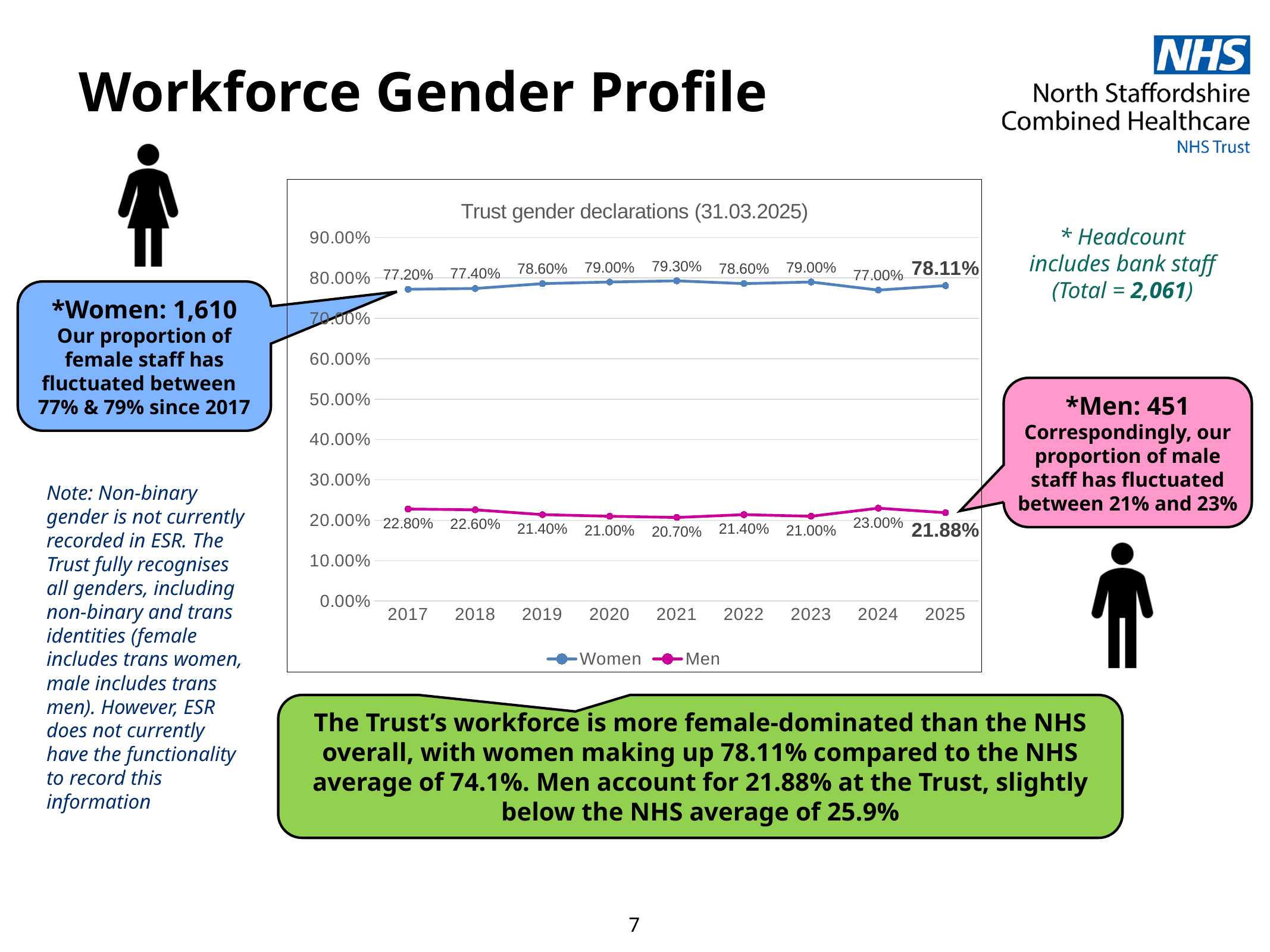
What kind of chart is shown? line chart How many series does the legend list? 2 What is the value for Women in 2021? 79.30% What is the value for Men in 2024? 23.00% In which year is the Women series at its highest? 2021 Is the value for Women in 2024 greater or less than 70.00%? greater What is the value for Women in 2025? 78.11% What is the title of the chart? Trust gender declarations (31.03.2025) What is the difference between the Women value in 2021 and the Women value in 2024? 2.30% In which year is the Men series at its lowest? 2021 Which is larger: the Men value in 2017 or the Men value in 2019? 2017 How many years are shown on the x axis? 9